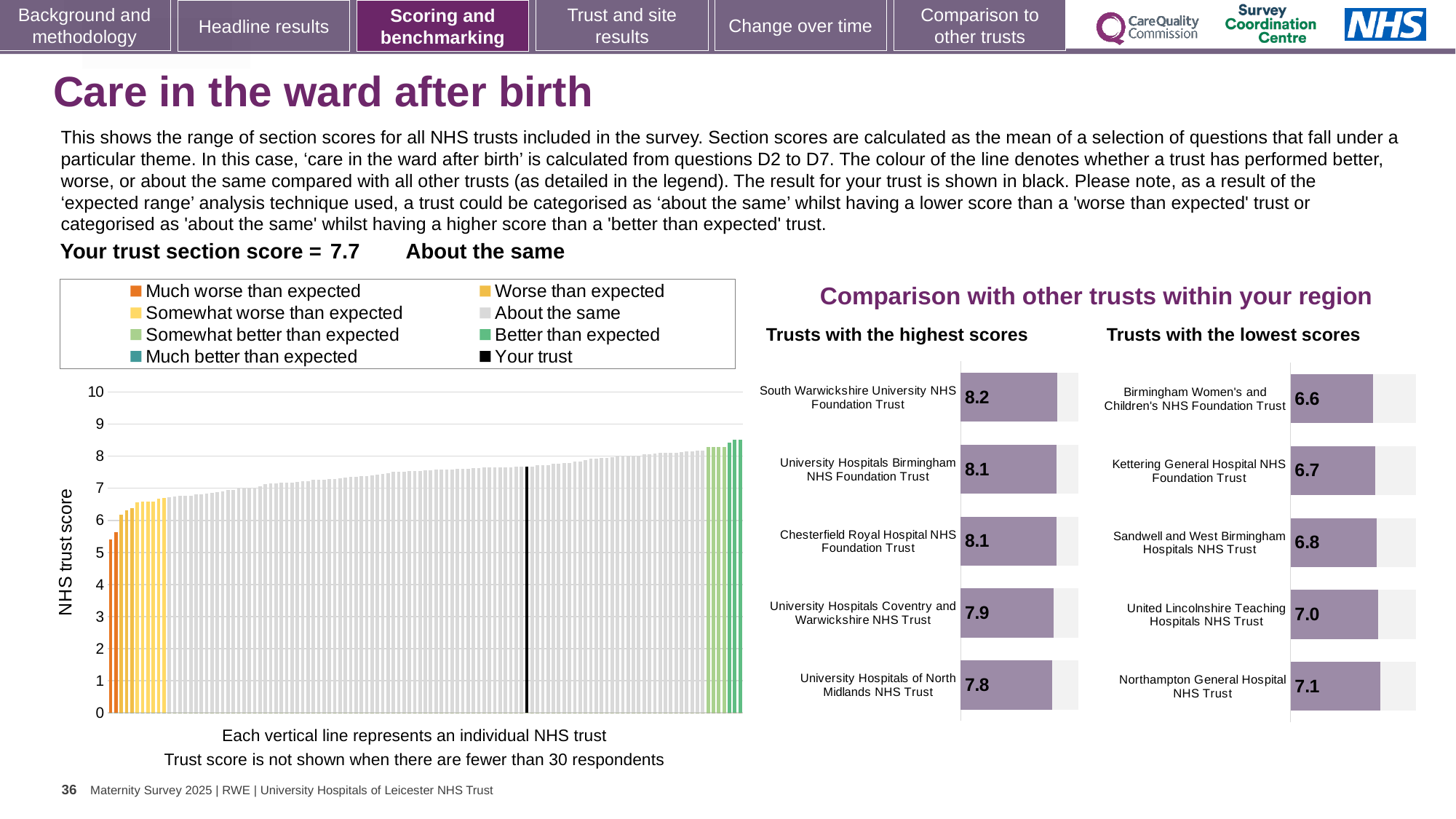
What kind of chart is the NHS trust score chart on the left? bar chart In the 'Trusts with the highest scores' chart, what is the score for University Hospitals Coventry and Warwickshire NHS Trust? 7.9 How many entries does the legend above the NHS trust score chart list? 8 In the NHS trust score chart on the left, do the bar values rise or fall from left to right? rise In the 'Trusts with the lowest scores' chart, what is the score for Birmingham Women's and Children's NHS Foundation Trust? 6.6 In the NHS trust score chart on the left, is the value for the black bar (your trust) greater or less than 7? greater In the 'Trusts with the highest scores' chart, what is the difference between the scores of South Warwickshire University NHS Foundation Trust and University Hospitals of North Midlands NHS Trust? 0.4 In the 'Trusts with the lowest scores' chart, which trust has the lowest score? Birmingham Women's and Children's NHS Foundation Trust In the 'Trusts with the highest scores' chart, what is the score for South Warwickshire University NHS Foundation Trust? 8.2 In the 'Trusts with the highest scores' chart, which trust has the highest score? South Warwickshire University NHS Foundation Trust In the 'Trusts with the lowest scores' chart, how many trusts are shown? 5 In the 'Trusts with the lowest scores' chart, which has the larger score: Kettering General Hospital NHS Foundation Trust or Sandwell and West Birmingham Hospitals NHS Trust? Sandwell and West Birmingham Hospitals NHS Trust